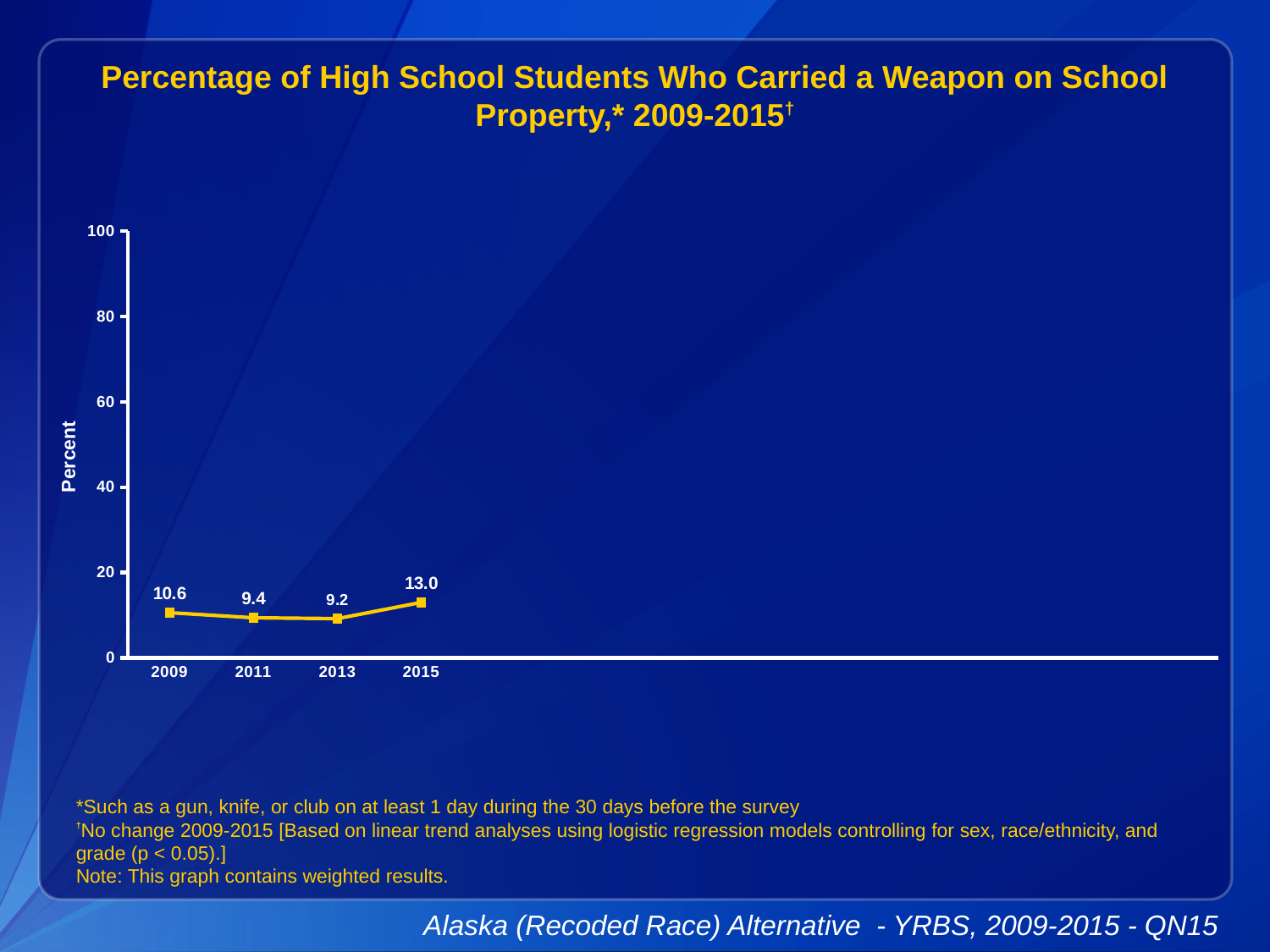
What value is shown for 2013? 9.2 How many years are plotted on the chart? 4 Is the value for 2015 greater or less than 20? less Which year has the lowest percentage? 2013 What is the difference between the 2011 value and the 2013 value? 0.2 What was the percentage of high school students who carried a weapon on school property in 2015? 13.0 What kind of chart is shown on the slide? line chart What is the label on the y axis? Percent What was the percentage of high school students who carried a weapon on school property in 2009? 10.6 Which year has the highest percentage? 2015 Which is larger, the value for 2009 or the value for 2011? 2009 What is the difference between the 2015 value and the 2009 value? 2.4